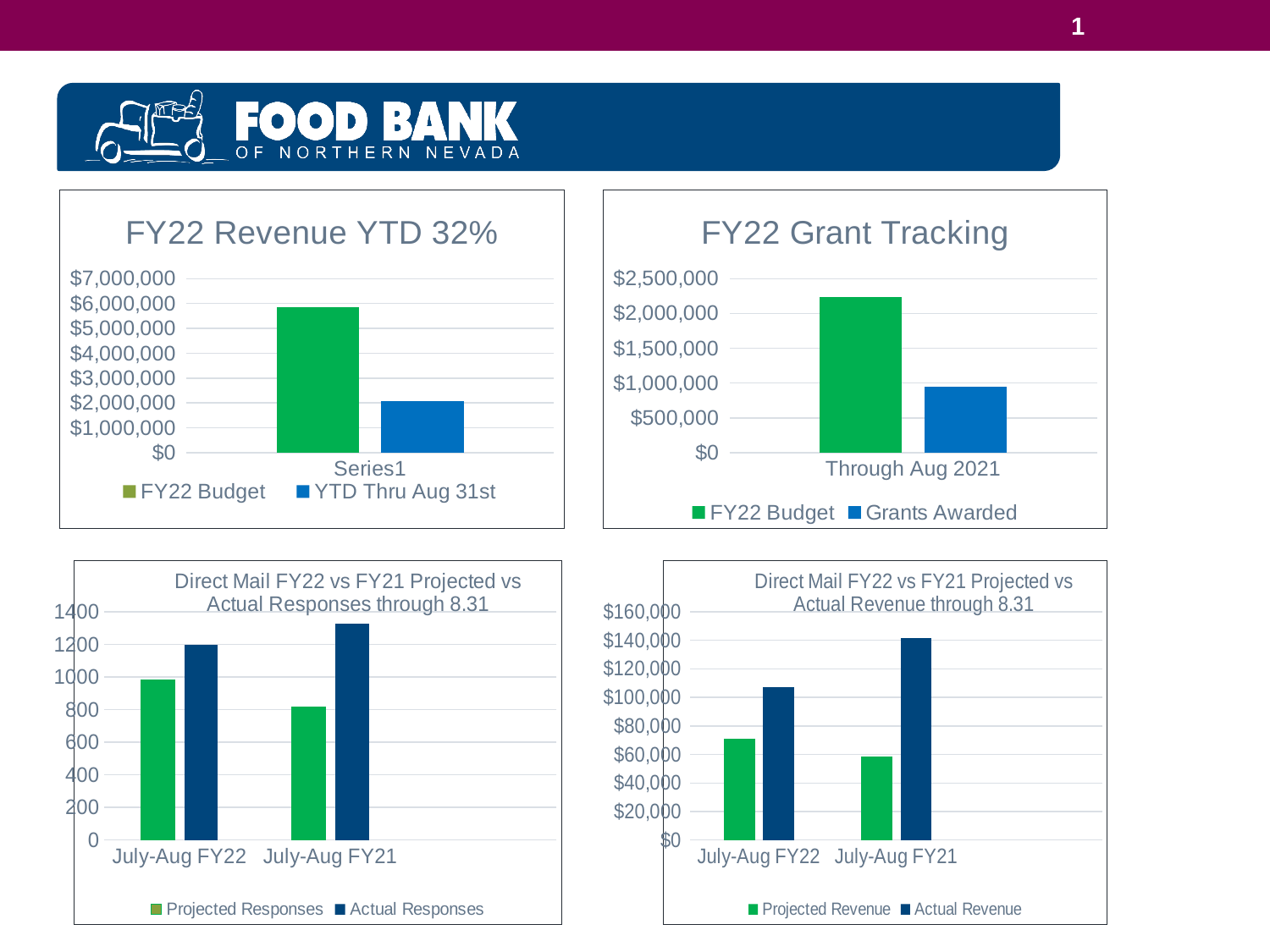
How many series does the legend of the FY22 Grant Tracking chart list? 2 In the FY22 Grant Tracking chart, is the value for FY22 Budget greater or less than $2,000,000? greater In the Direct Mail Projected vs Actual Responses chart, which is larger for July-Aug FY22, Projected Responses or Actual Responses? Actual Responses In the FY22 Revenue YTD 32% chart, is the value for YTD Thru Aug 31st greater or less than $3,000,000? less In the Direct Mail Projected vs Actual Revenue chart, is the value for Actual Revenue in July-Aug FY21 greater or less than $120,000? greater How many categories are shown on the x axis of the Direct Mail Projected vs Actual Responses chart? 2 In the FY22 Revenue YTD 32% chart, which is larger, FY22 Budget or YTD Thru Aug 31st? FY22 Budget What kind of chart is the FY22 Grant Tracking chart? bar chart